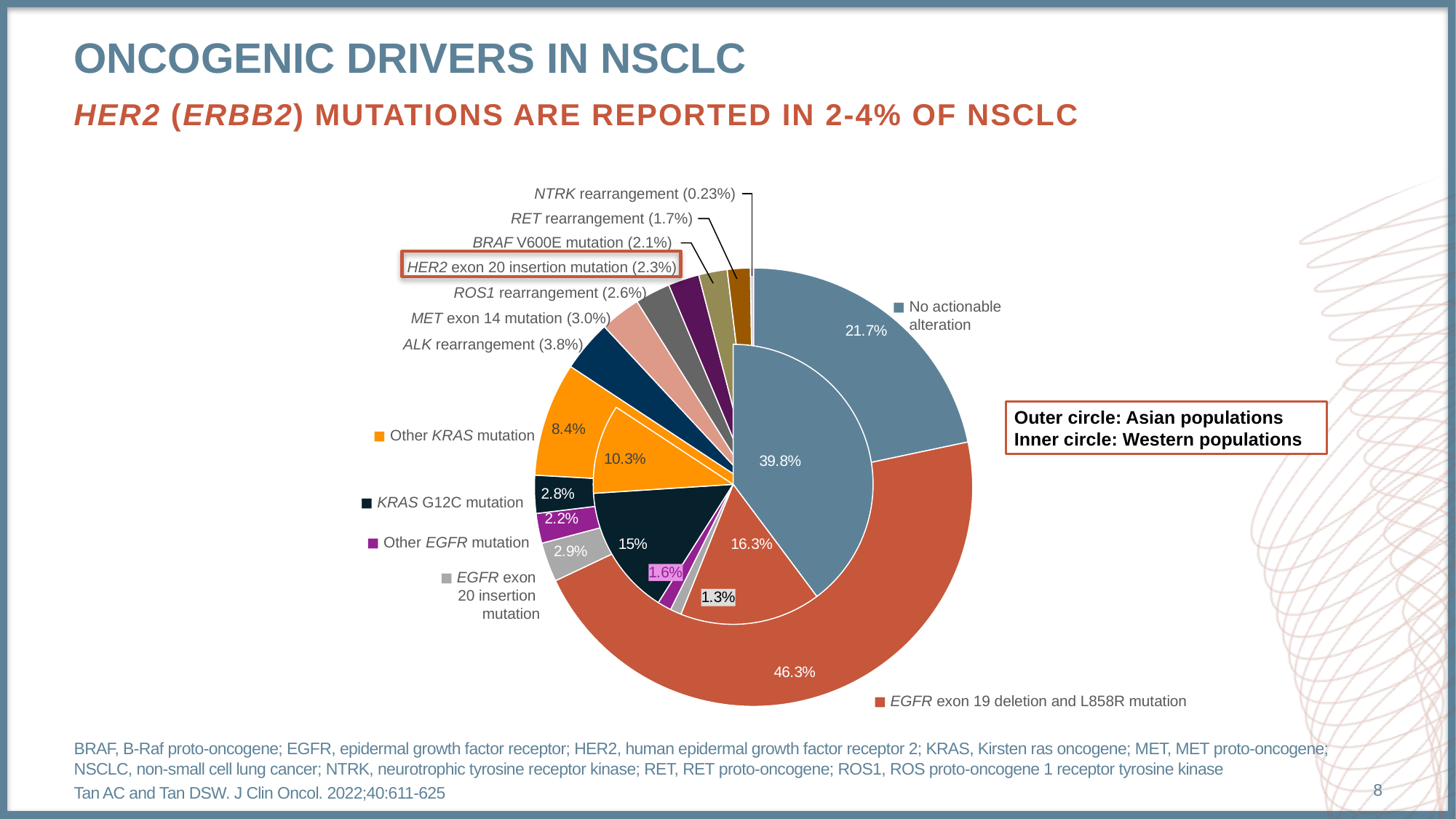
What percentage is given for HER2 exon 20 insertion mutation in the outer circle? 2.3% What is the difference between the 'No actionable alteration' share in the inner circle (39.8%) and in the outer circle (21.7%)? 18.1% According to the inner circle (Western populations), what percentage of NSCLC has no actionable alteration? 39.8% What percentage is given for KRAS G12C mutation in the inner circle (Western populations)? 15% Which is larger: the Other KRAS mutation share in the inner circle or in the outer circle? Inner circle (10.3%) What percentage is given for NTRK rearrangement in the outer circle? 0.23% Which category label is highlighted with a red box on the chart? HER2 exon 20 insertion mutation (2.3%) Which category has the largest share in the outer circle (Asian populations)? EGFR exon 19 deletion and L858R mutation What population does the outer circle of the chart represent? Asian populations What kind of chart is shown on the slide? Pie chart (doughnut) According to the outer circle (Asian populations), what percentage of NSCLC has an EGFR exon 19 deletion and L858R mutation? 46.3% Which category has the smallest share in the outer circle (Asian populations)? NTRK rearrangement